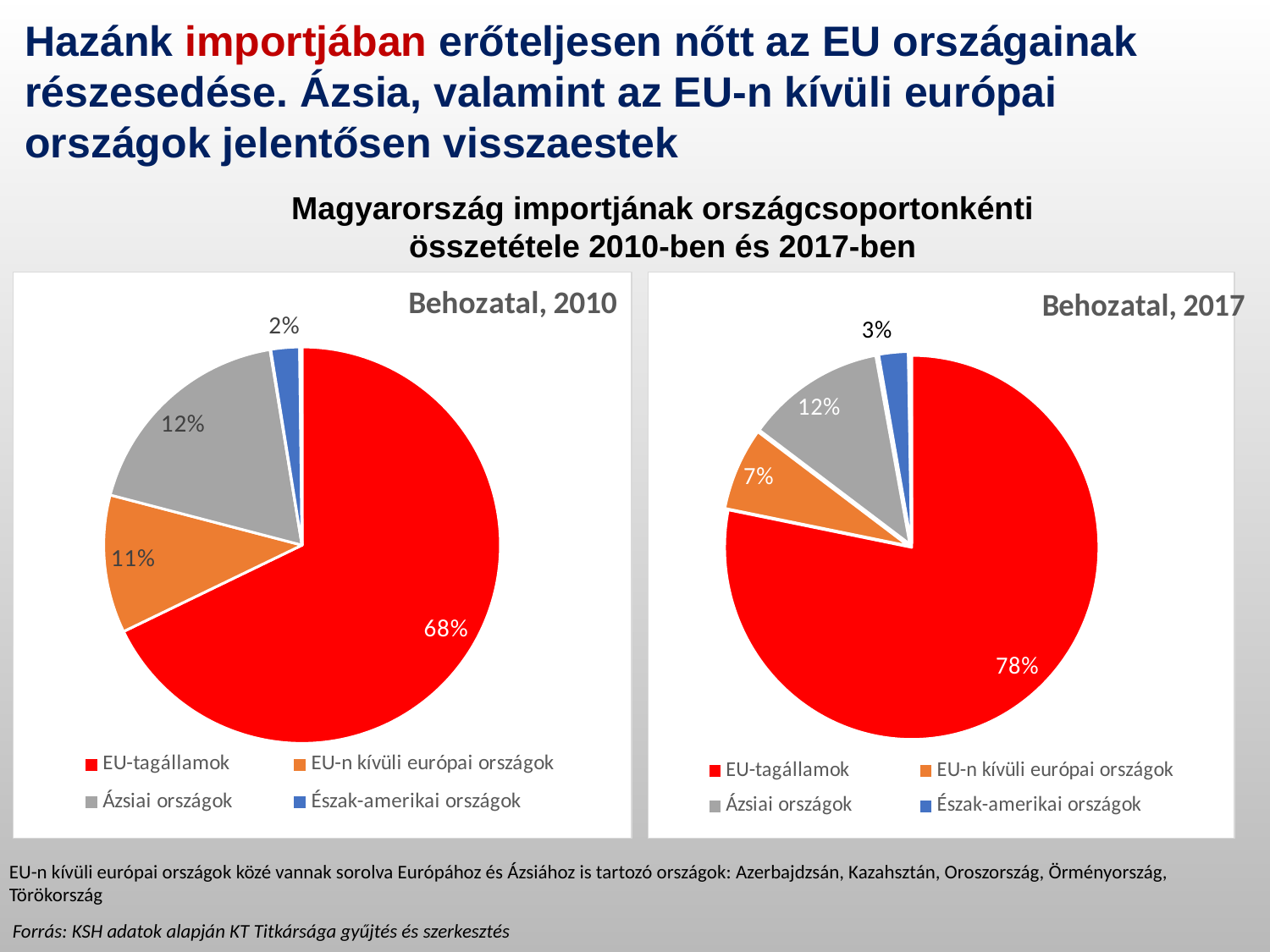
In the 'Behozatal, 2010' pie chart, what share do EU-tagállamok have? 68% In the 'Behozatal, 2010' pie chart, what share do EU-n kívüli európai országok have? 11% In the 'Behozatal, 2017' pie chart, which category has the largest slice? EU-tagállamok Which colour represents Ázsiai országok in the pie charts? Grey In the 'Behozatal, 2010' pie chart, what is the combined share of Ázsiai országok and EU-n kívüli európai országok? 23% How much larger is the EU-tagállamok share in the 'Behozatal, 2017' chart than in the 'Behozatal, 2010' chart? 10 percentage points How many categories does the legend of the 'Behozatal, 2010' chart list? 4 What type of chart is 'Behozatal, 2017'? Pie chart In the 'Behozatal, 2010' pie chart, which category has the smallest slice? Észak-amerikai országok In the 'Behozatal, 2017' pie chart, which is larger: the share of Ázsiai országok or the share of EU-n kívüli európai országok? Ázsiai országok In the 'Behozatal, 2017' pie chart, what share do Észak-amerikai országok have? 3% In the 'Behozatal, 2017' pie chart, what share do EU-tagállamok have? 78%